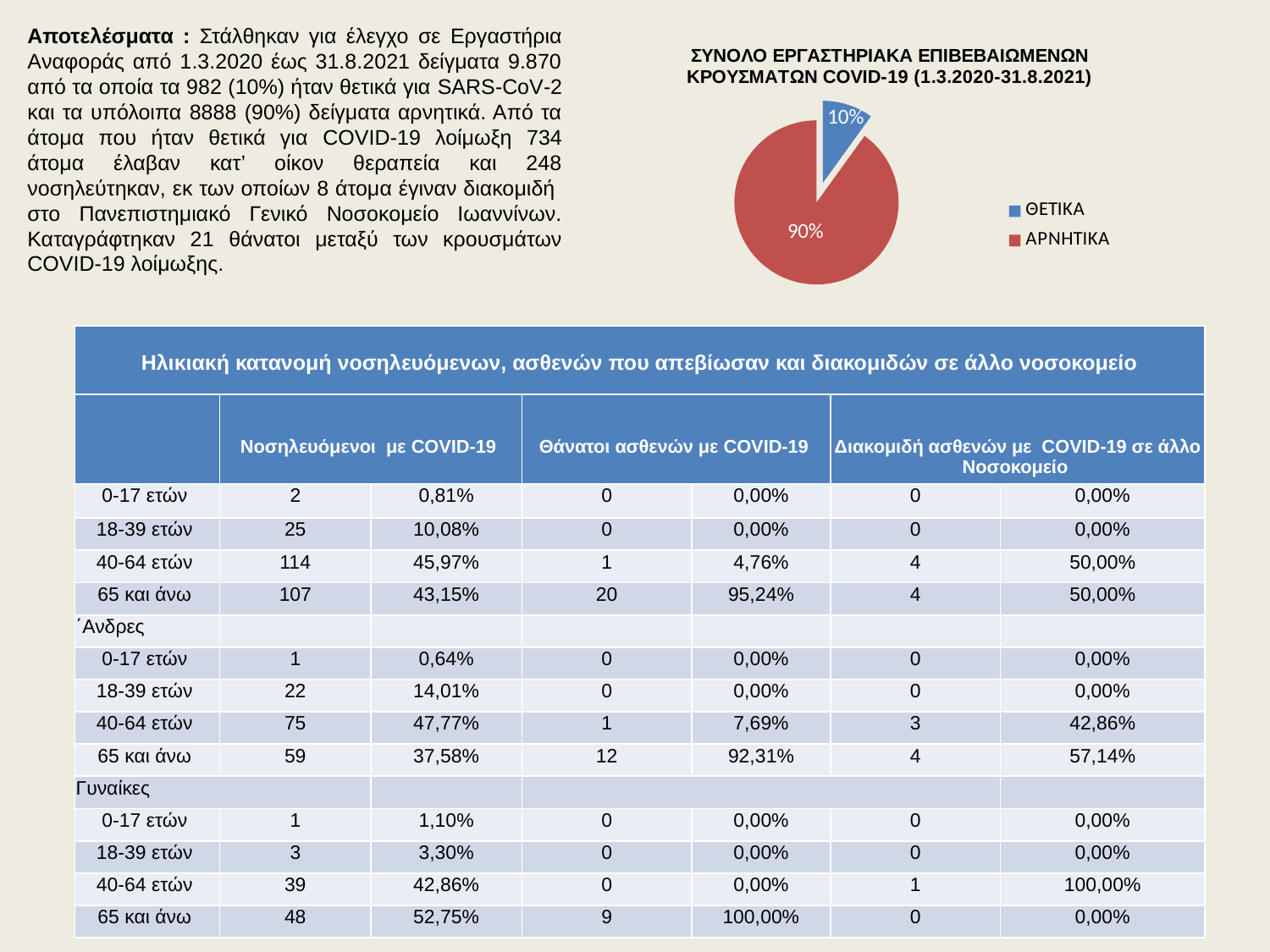
How many slices does the pie chart have? 2 What share of the pie chart does ΘΕΤΙΚΑ represent? 10% Which slice of the pie chart is the smallest? ΘΕΤΙΚΑ What date range is given in the title of the pie chart? 1.3.2020-31.8.2021 Which slice of the pie chart is the largest? ΑΡΝΗΤΙΚΑ Which is larger in the pie chart, ΘΕΤΙΚΑ or ΑΡΝΗΤΙΚΑ? ΑΡΝΗΤΙΚΑ What is the difference in percentage points between the ΑΡΝΗΤΙΚΑ and ΘΕΤΙΚΑ slices of the pie chart? 80% What colour is the ΘΕΤΙΚΑ slice in the pie chart? blue What share of the pie chart does ΑΡΝΗΤΙΚΑ represent? 90% How many entries does the legend of the pie chart list? 2 What kind of chart is shown on the slide? pie chart